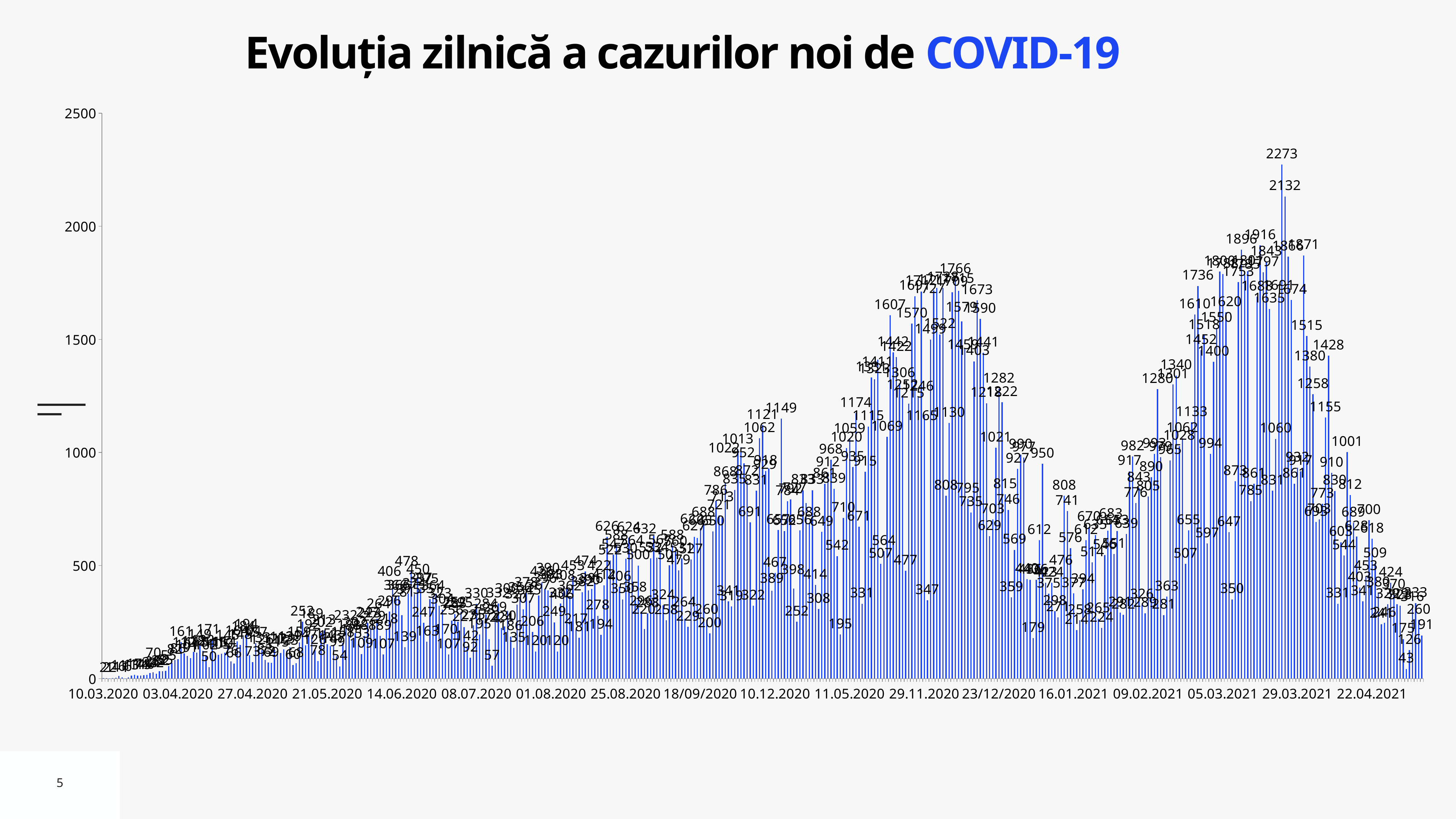
What is the title of the chart? Evoluția zilnică a cazurilor noi de COVID-19 What is the last date label on the horizontal axis? 22.04.2021 What is the first date label on the horizontal axis? 10.03.2020 What is the maximum value shown on the vertical axis? 2500 What kind of chart is shown on the slide? bar chart What is the highest daily value labelled on the chart? 2273 What is the difference between the two highest labelled values, 2273 and 2132? 141 How many date labels are shown on the horizontal axis? 18 Do the values rise or fall between 10.03.2020 and 03.04.2020? rise Is the highest value on the chart greater or less than 2000? greater Is the value labelled 43 near the right end of the chart greater or less than 500? less Which is larger, the peak value 2273 or the neighbouring value 2132? 2273